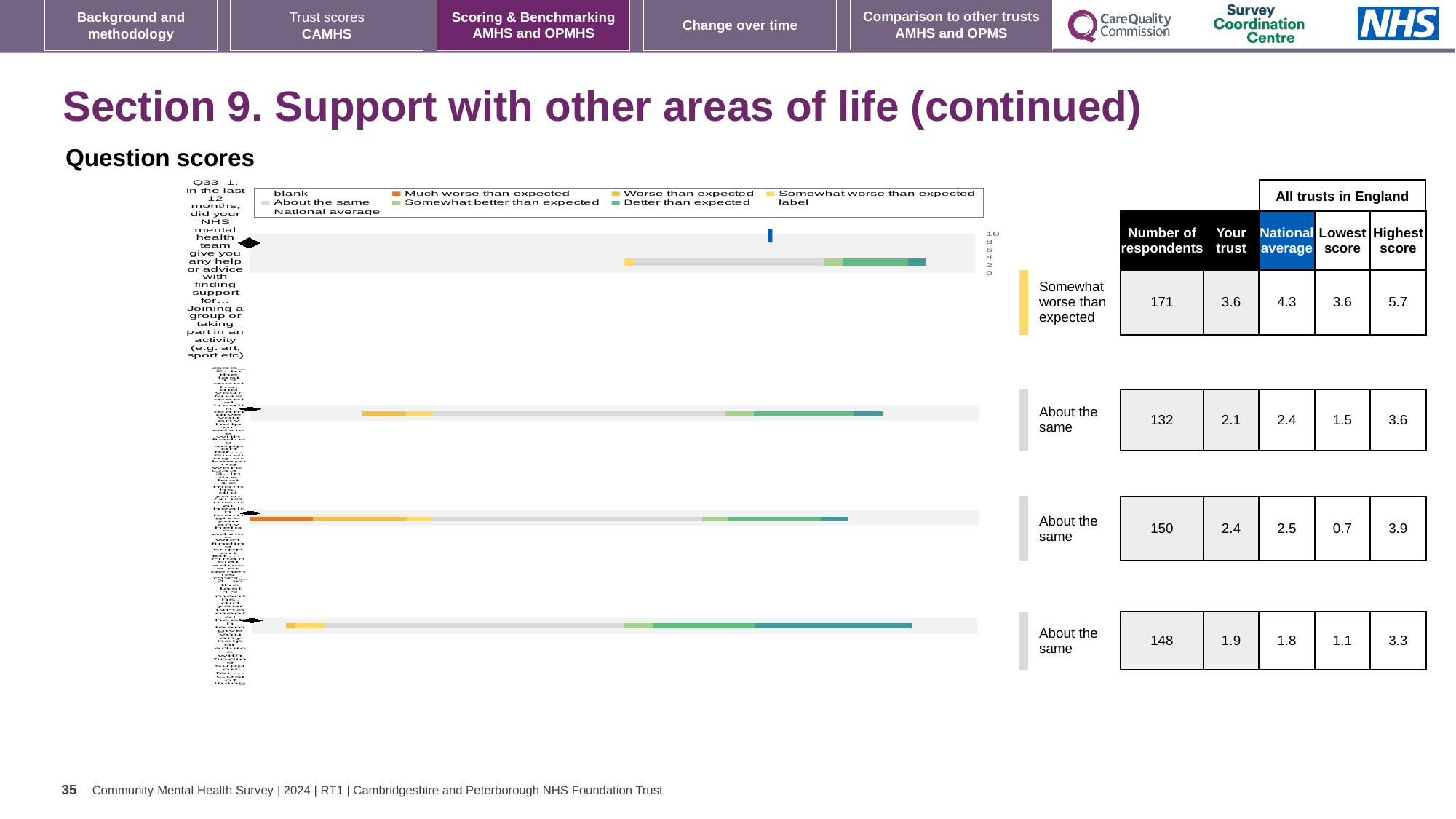
Which legend entry is shown in orange-red in the chart's legend? Much worse than expected What is the highest score across all trusts in England for the top bar (Q33_1)? 5.7 What type of chart is shown under 'Question scores'? bar chart What is the national average for the top bar (Q33_1, joining a group or taking part in an activity)? 4.3 What is the lowest score across all trusts in England for the bottom bar? 1.1 Which benchmark category is assigned to the top bar (Q33_1, joining a group or taking part in an activity)? Somewhat worse than expected For the top bar (Q33_1), which is larger: the 'Your trust' score or the national average? National average What is the 'Your trust' score for the top bar (Q33_1, joining a group or taking part in an activity)? 3.6 For the top bar (Q33_1), what is the difference between the national average and the 'Your trust' score? 0.7 How many respondents answered the question shown in the top bar (Q33_1)? 171 Which bar has the highest number of respondents? The top bar (Q33_1), with 171 How many horizontal bars (question rows) does the chart contain? 4